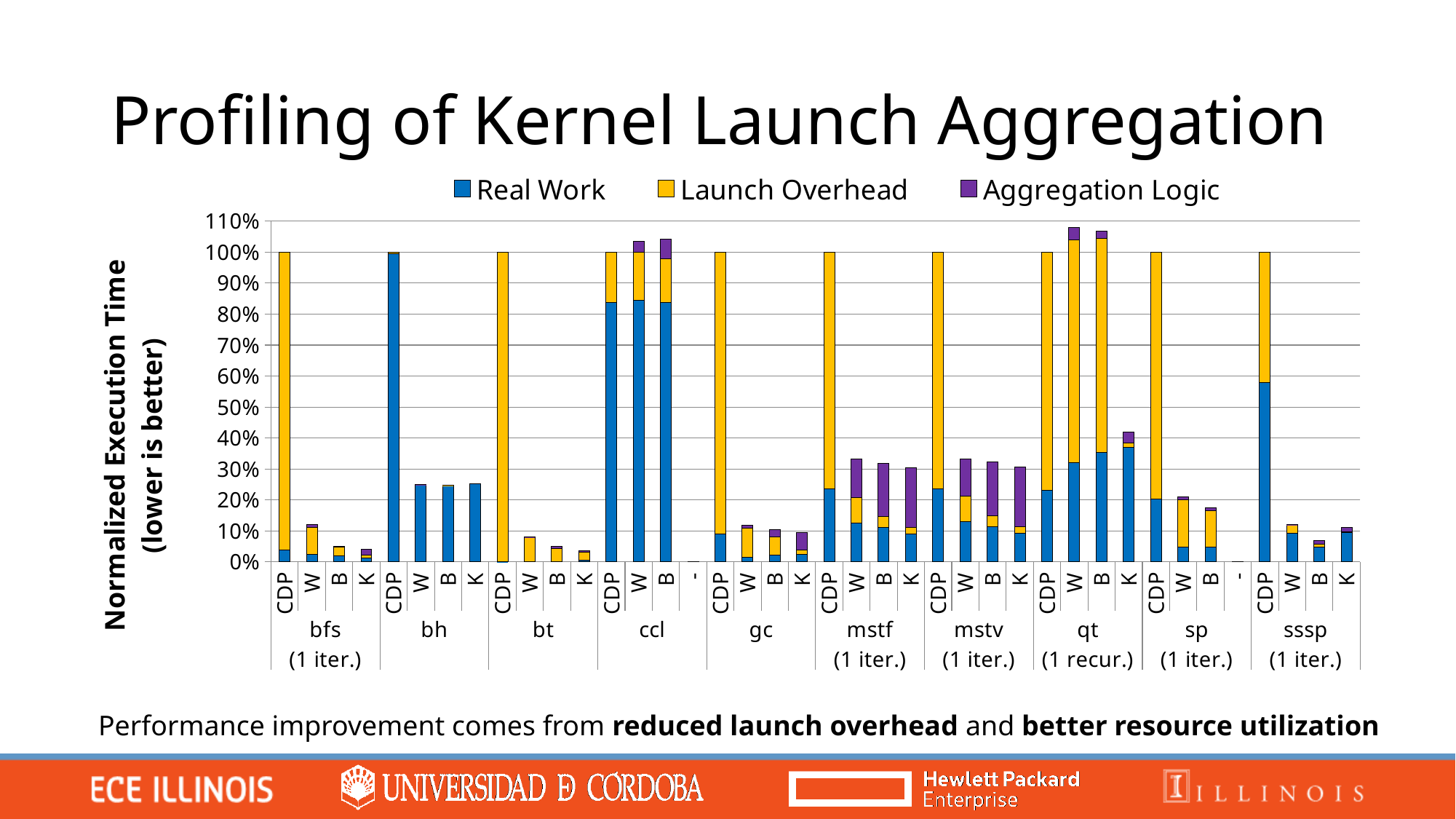
In the bh group, which bar has the larger total: CDP or W? CDP What kind of chart is shown on the slide? bar chart Is the Real Work value for the CDP bar in the sssp group greater or less than 50%? greater In the sp group, which bar has the highest total normalized execution time? CDP What is the total normalized execution time for the CDP bar in the bfs group? 100% How many series does the legend list? 3 What are the three series named in the legend? Real Work, Launch Overhead, Aggregation Logic Is the total value for the K bar in the mstf group greater or less than 40%? less Is the total value for the W bar in the ccl group greater or less than 100%? greater What is the y-axis title of the chart? Normalized Execution Time (lower is better) How many benchmark groups are shown along the x axis? 10